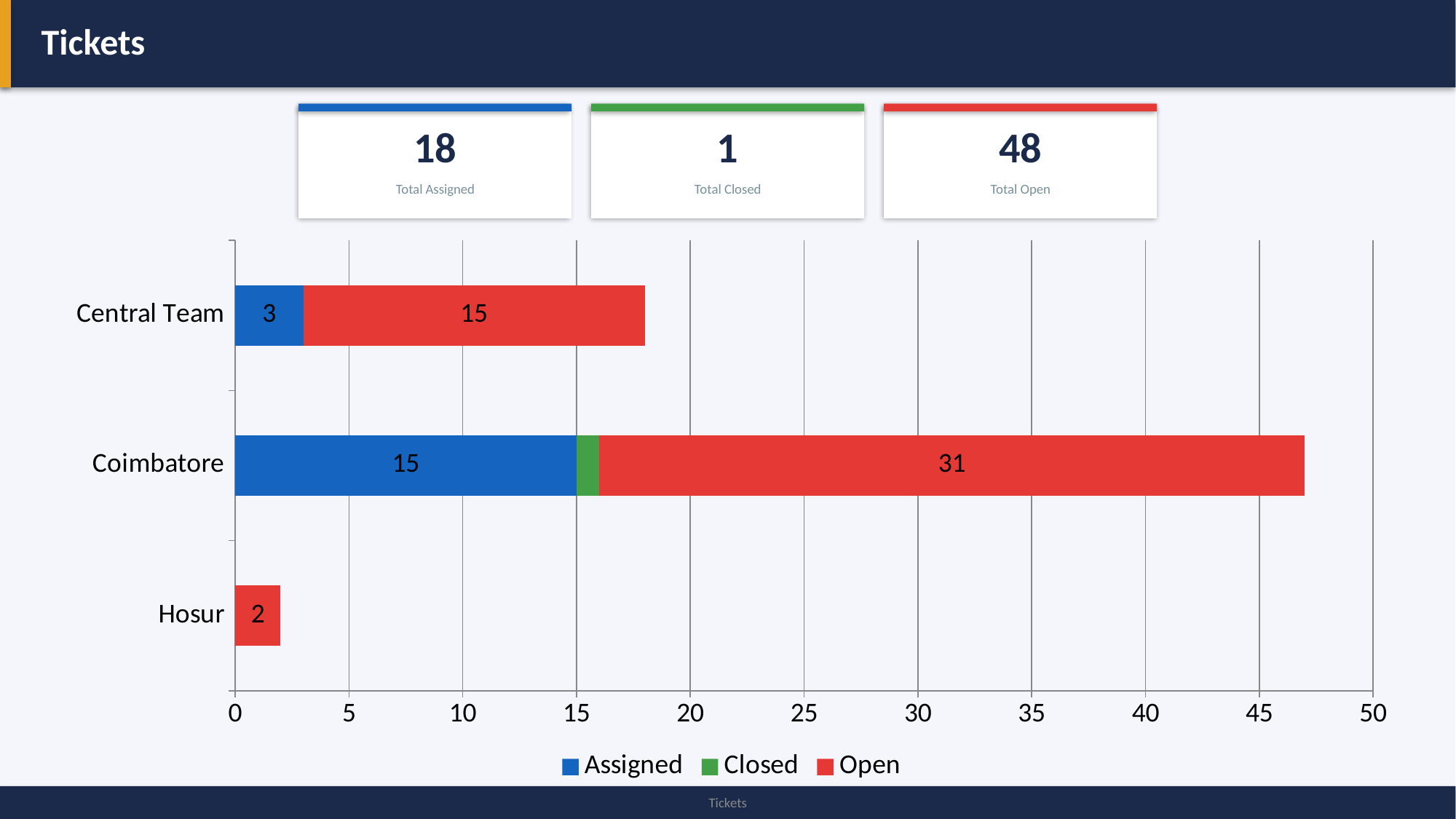
How many categories are shown on the chart? 3 Which category has the highest Open value? Coimbatore What kind of chart is shown on the slide? Stacked bar chart What is the Open value for Central Team? 15 What is the difference between the Open value for Coimbatore and the Open value for Central Team? 16 What is the Assigned value for Coimbatore? 15 Which has a larger Assigned value, Coimbatore or Central Team? Coimbatore What is the Assigned value for Central Team? 3 What is the Open value for Hosur? 2 What is the total of the stacked bar for Central Team? 18 Is the total length of the Coimbatore bar greater or less than 45? greater How many series does the legend list? 3